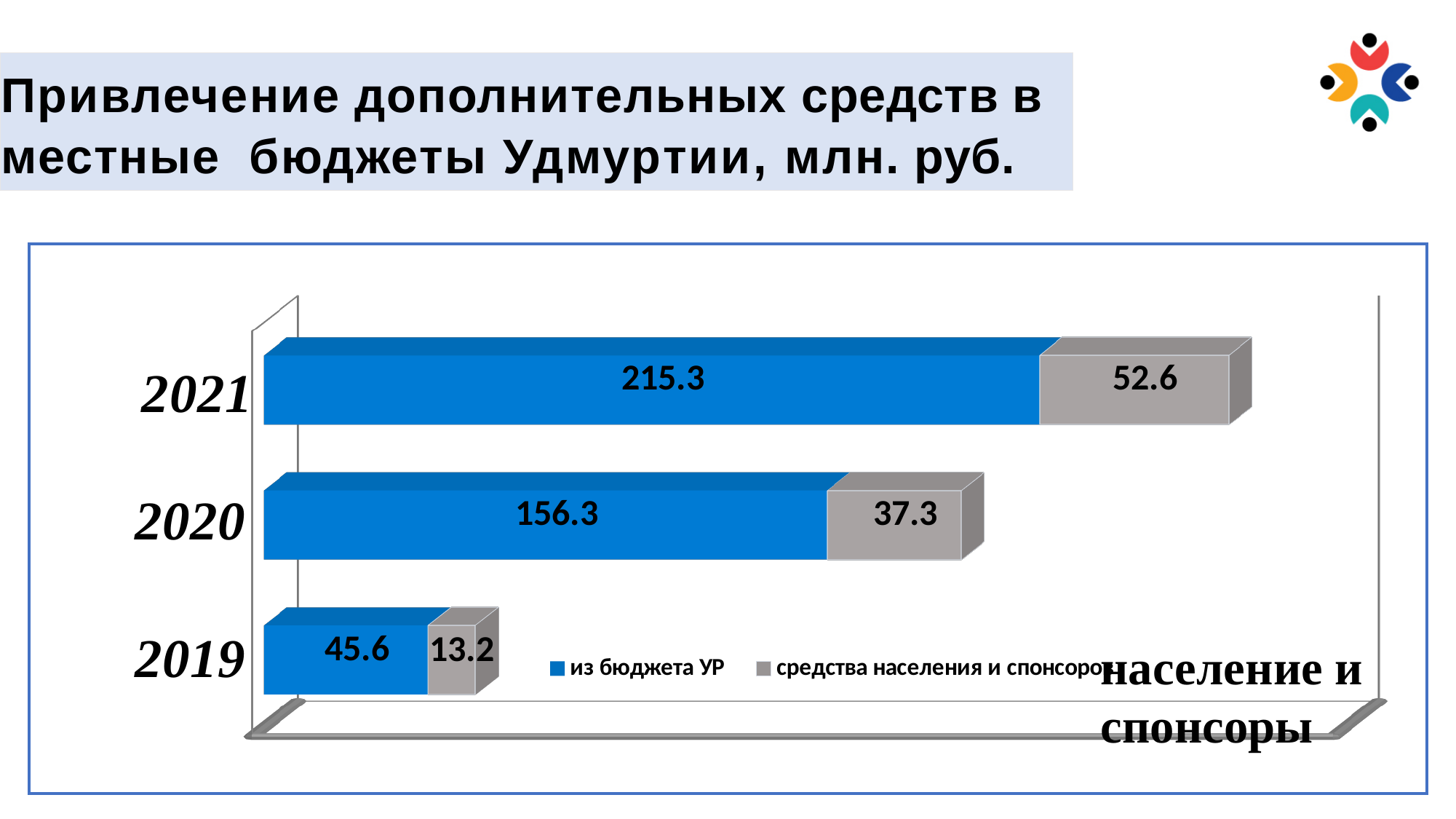
What is the difference between the "из бюджета УР" values for 2021 and 2020? 59.0 How many series does the legend list? 2 What is the total of the stacked bar for 2019? 58.8 Which year has the lowest value for "средства населения и спонсоров"? 2019 Which year has the highest value for "из бюджета УР"? 2021 What is the difference between the "средства населения и спонсоров" values for 2021 and 2020? 15.3 Which is larger: the "из бюджета УР" value for 2020 or the "средства населения и спонсоров" value for 2021? из бюджета УР for 2020 What is the value for "средства населения и спонсоров" in 2019? 13.2 What is the total of the stacked bar for 2021? 267.9 What is the value for "из бюджета УР" in 2019? 45.6 What is the value for "средства населения и спонсоров" in 2020? 37.3 What is the value for "из бюджета УР" in 2021? 215.3